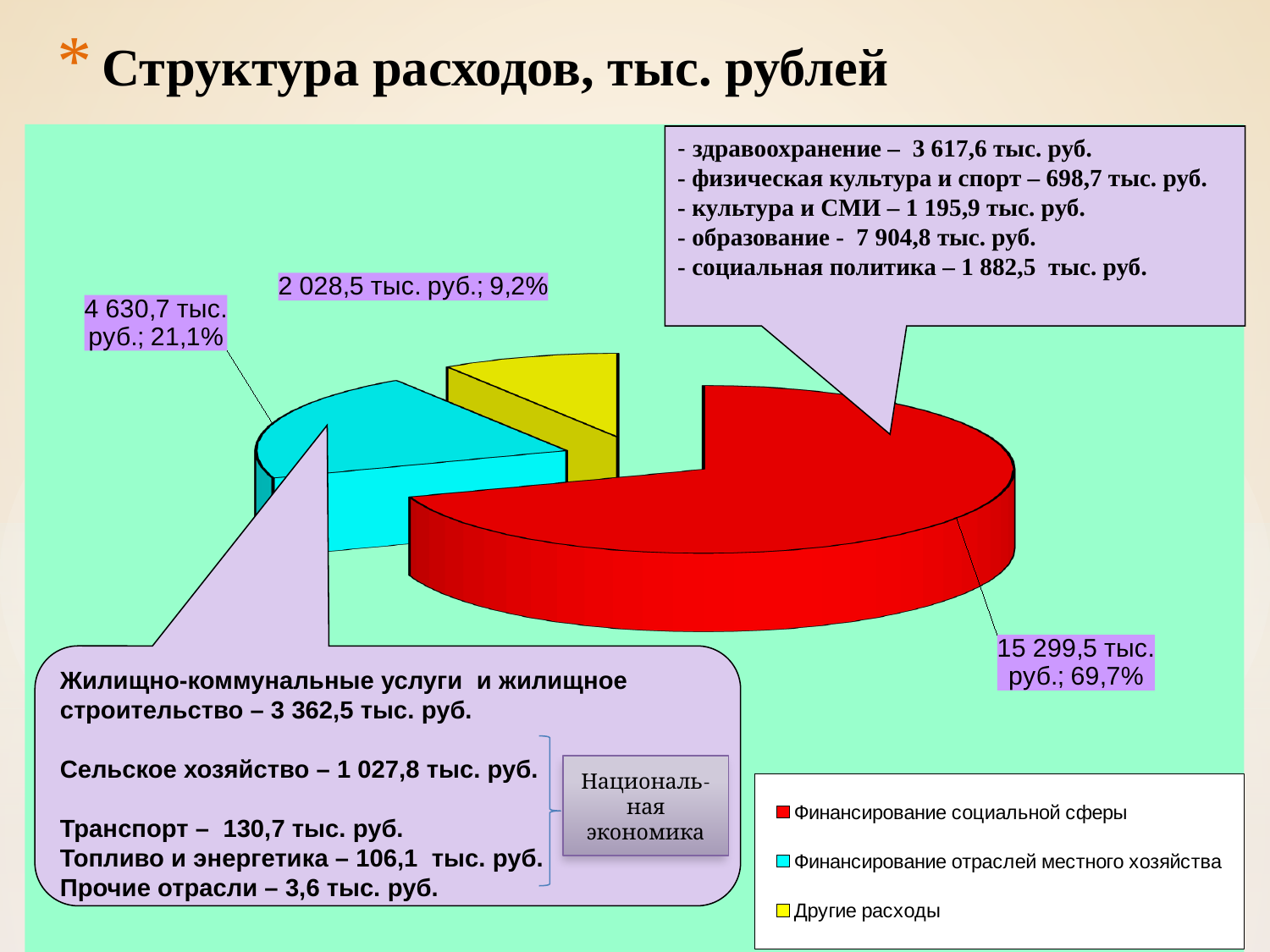
What value is shown for Финансирование отраслей местного хозяйства? 4 630,7 тыс. руб. Which colour represents Финансирование отраслей местного хозяйства in the pie chart? cyan How many entries does the legend list? 3 What share of the pie does Финансирование социальной сферы take? 69,7% What value is shown for Другие расходы? 2 028,5 тыс. руб. What share of the pie does Другие расходы take? 9,2% What kind of chart is shown on the slide? pie chart Which category has the largest slice of the pie? Финансирование социальной сферы What is the title of the slide's chart? Структура расходов, тыс. рублей What value is shown for Финансирование социальной сферы? 15 299,5 тыс. руб. Which category has the smallest slice of the pie? Другие расходы How many slices does the pie chart have? 3